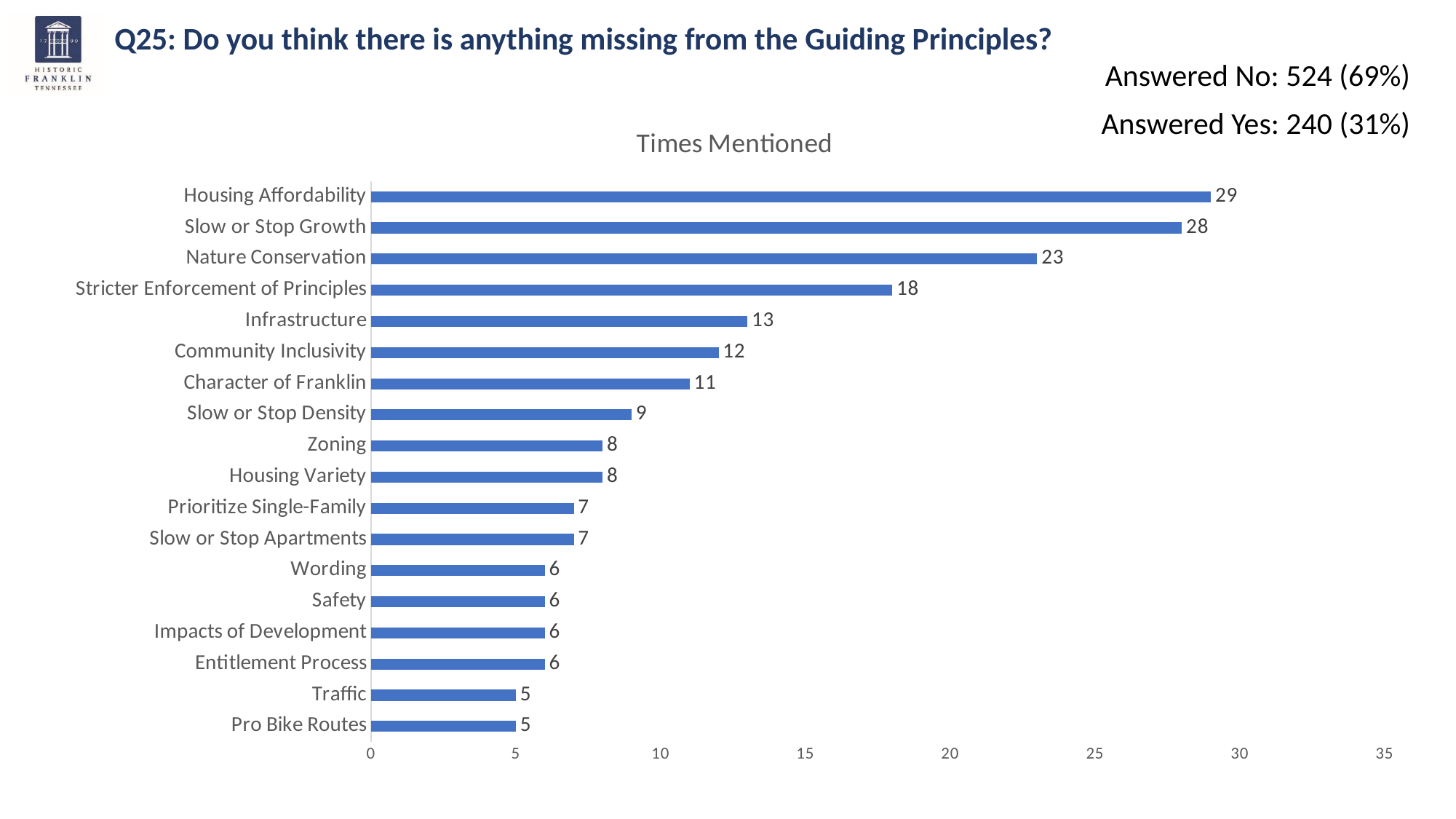
What is the difference between Nature Conservation and Infrastructure? 10 Is the value for Slow or Stop Growth greater or less than 25? greater What kind of chart is shown on the slide? bar chart What is the value for Nature Conservation? 23 What is the difference between Housing Affordability and Slow or Stop Growth? 1 Which is larger, Community Inclusivity or Character of Franklin? Community Inclusivity How many categories are shown in the chart? 18 Which category has the highest number of times mentioned? Housing Affordability What is the value for Traffic? 5 What is the title of the chart? Times Mentioned How many times was Housing Affordability mentioned? 29 How many times was Stricter Enforcement of Principles mentioned? 18